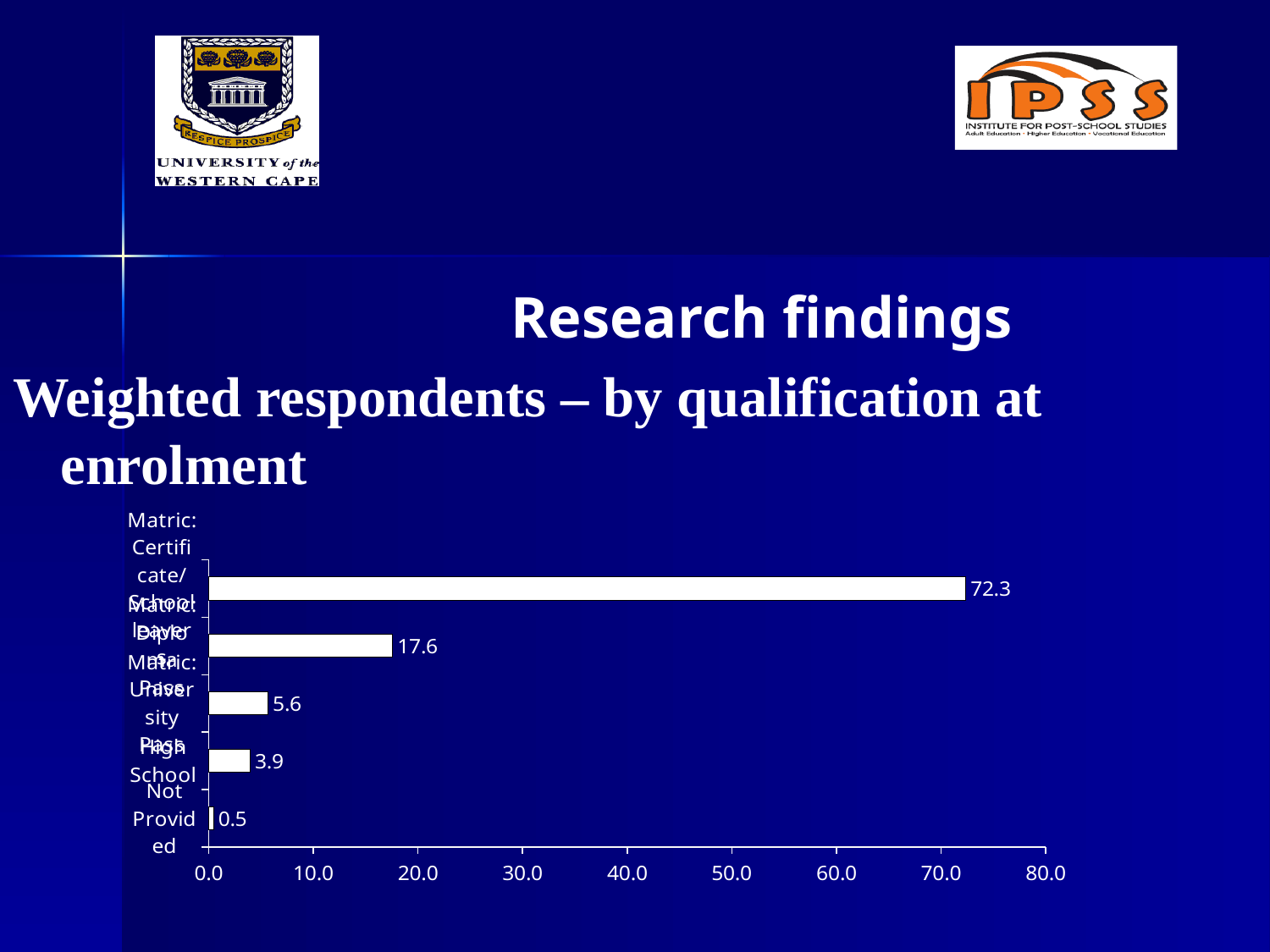
What is the difference between the top bar (72.3) and the second bar (17.6)? 54.7 What is the maximum value shown on the horizontal axis? 80.0 What type of chart is shown on the slide? bar chart Which is larger: the value for 'High School' or the value for 'Not Provided'? High School What is the value for the 'High School' category? 3.9 What is the value of the longest bar in the chart? 72.3 What is the value of the third bar from the top? 5.6 What is the value of the shortest bar in the chart? 0.5 What is the value of the second bar from the top? 17.6 What is the value for the 'Not Provided' category? 0.5 How many bars are plotted in the chart? 5 Is the value of the top bar greater or less than 70.0? greater